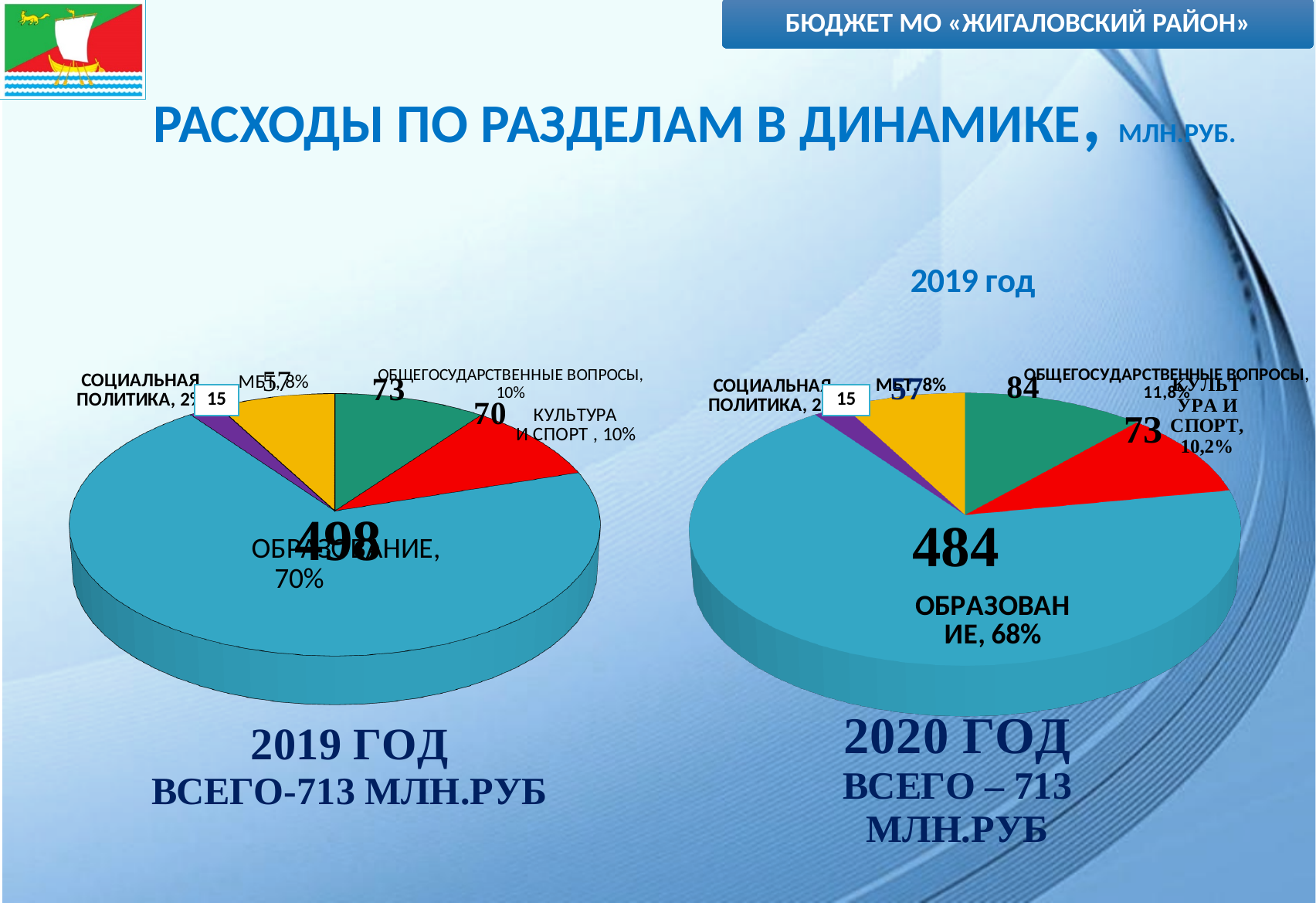
What kind of chart is used for the 2019 год chart on the left? pie chart In the 2020 год chart, what is the value for ОБРАЗОВАНИЕ? 484 In the 2020 год chart, which is larger: ОБЩЕГОСУДАРСТВЕННЫЕ ВОПРОСЫ or КУЛЬТУРА И СПОРТ? ОБЩЕГОСУДАРСТВЕННЫЕ ВОПРОСЫ In the 2020 год chart, which section has the largest slice? ОБРАЗОВАНИЕ In the 2019 год chart, what is the value for КУЛЬТУРА И СПОРТ? 70 In the 2019 год chart, what is the value for ОБРАЗОВАНИЕ? 498 In the 2019 год chart, what is the value for ОБЩЕГОСУДАРСТВЕННЫЕ ВОПРОСЫ? 73 In the 2020 год chart, what share of the pie does КУЛЬТУРА И СПОРТ take? 10,2% How many slices does the 2020 год pie chart have? 5 By how much does the value for ОБРАЗОВАНИЕ in the 2019 год chart exceed the value in the 2020 год chart? 14 In the 2020 год chart, what is the value for ОБЩЕГОСУДАРСТВЕННЫЕ ВОПРОСЫ? 84 In the 2019 год chart, what share of the pie does ОБРАЗОВАНИЕ take? 70%